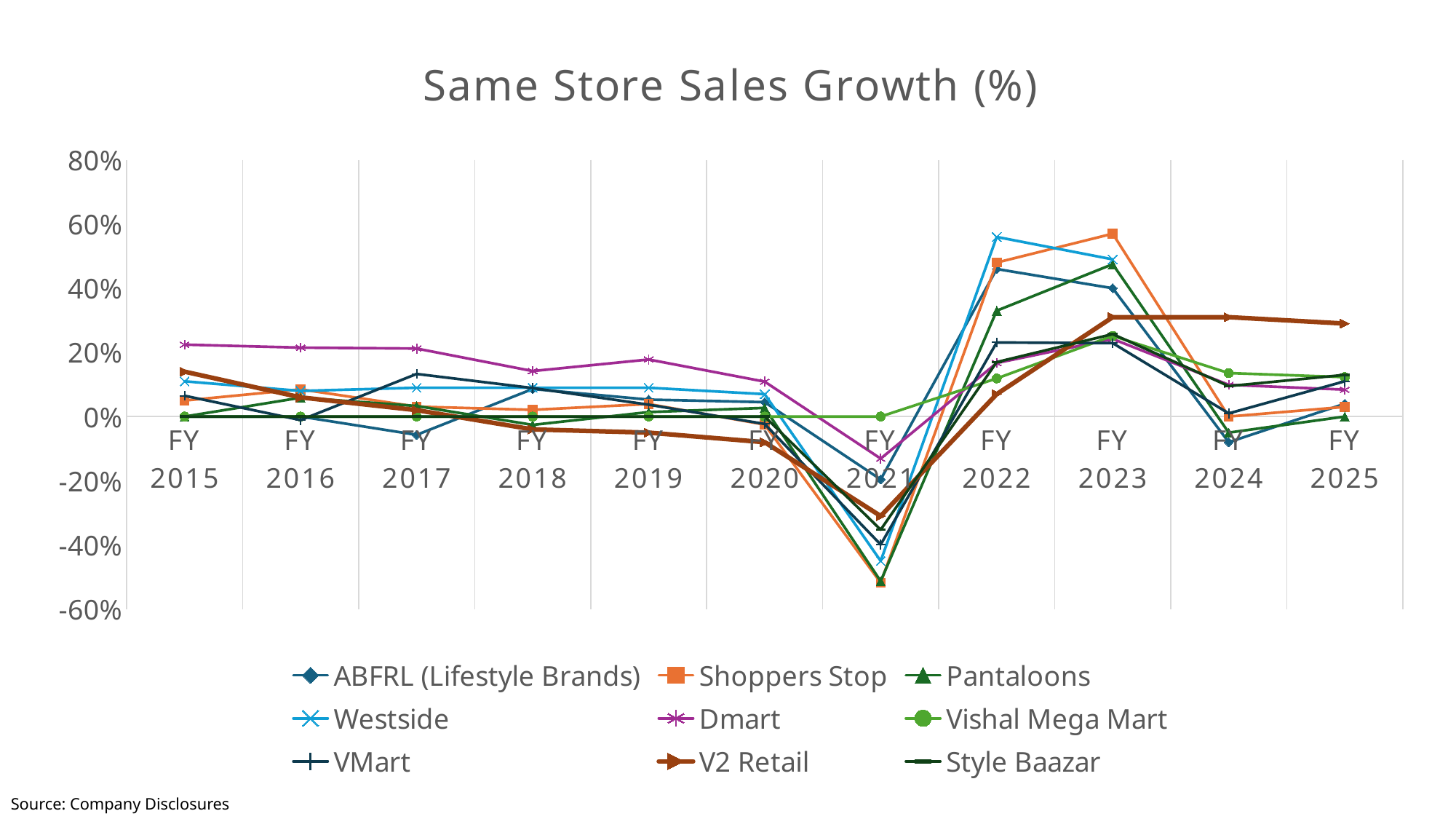
What kind of chart is shown on the slide? Line chart What is the title of the chart? Same Store Sales Growth (%) In FY 2019, which is larger: the value for Dmart or the value for Westside? Dmart Which series has the highest value in FY 2023? Shoppers Stop Which series has the highest value in FY 2025? V2 Retail Is the value for Shoppers Stop in FY 2021 greater or less than -40%? less What is the value for Vishal Mega Mart in FY 2021? 0% How many fiscal years are plotted along the x axis? 11 Does the Dmart line rise or fall from FY 2015 to FY 2021? Fall Which series has the highest value in FY 2022? Westside How many series does the legend list? 9 Is the value for V2 Retail in FY 2024 greater or less than 20%? greater